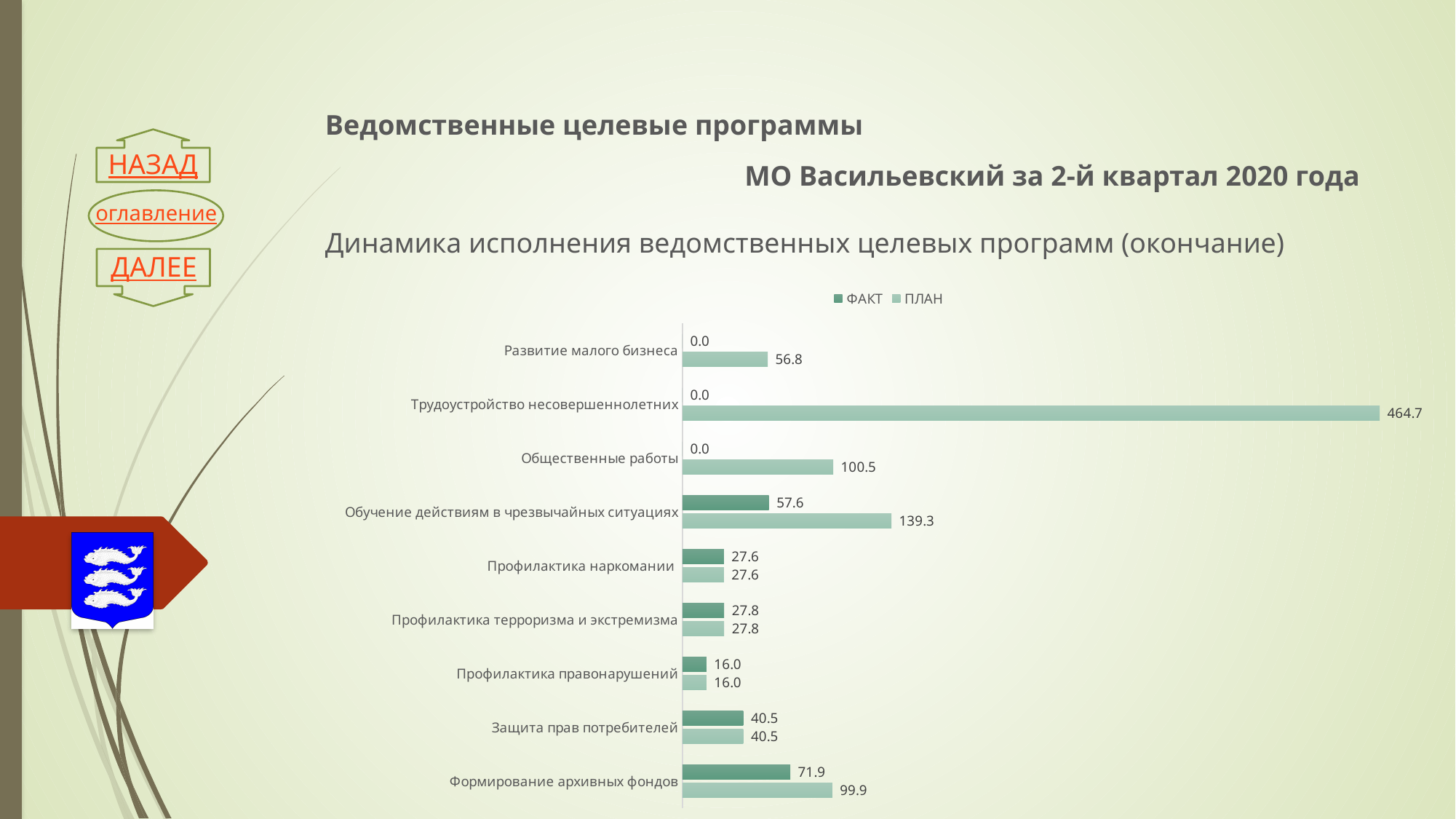
What is the ФАКТ value for Развитие малого бизнеса? 0.0 Which is larger: the ПЛАН value for Общественные работы or the ПЛАН value for Развитие малого бизнеса? Общественные работы What is the difference between the ПЛАН and ФАКТ values for Формирование архивных фондов? 28.0 What is the ПЛАН value for Трудоустройство несовершеннолетних? 464.7 What is the ФАКТ value for Обучение действиям в чрезвычайных ситуациях? 57.6 How many categories are shown on the chart? 9 Which category has the highest ПЛАН value? Трудоустройство несовершеннолетних How many series does the legend list? 2 What is the ПЛАН value for Формирование архивных фондов? 99.9 Which category has the lowest ПЛАН value? Профилактика правонарушений What is the difference between the ПЛАН and ФАКТ values for Обучение действиям в чрезвычайных ситуациях? 81.7 What kind of chart is shown on the slide? Bar chart